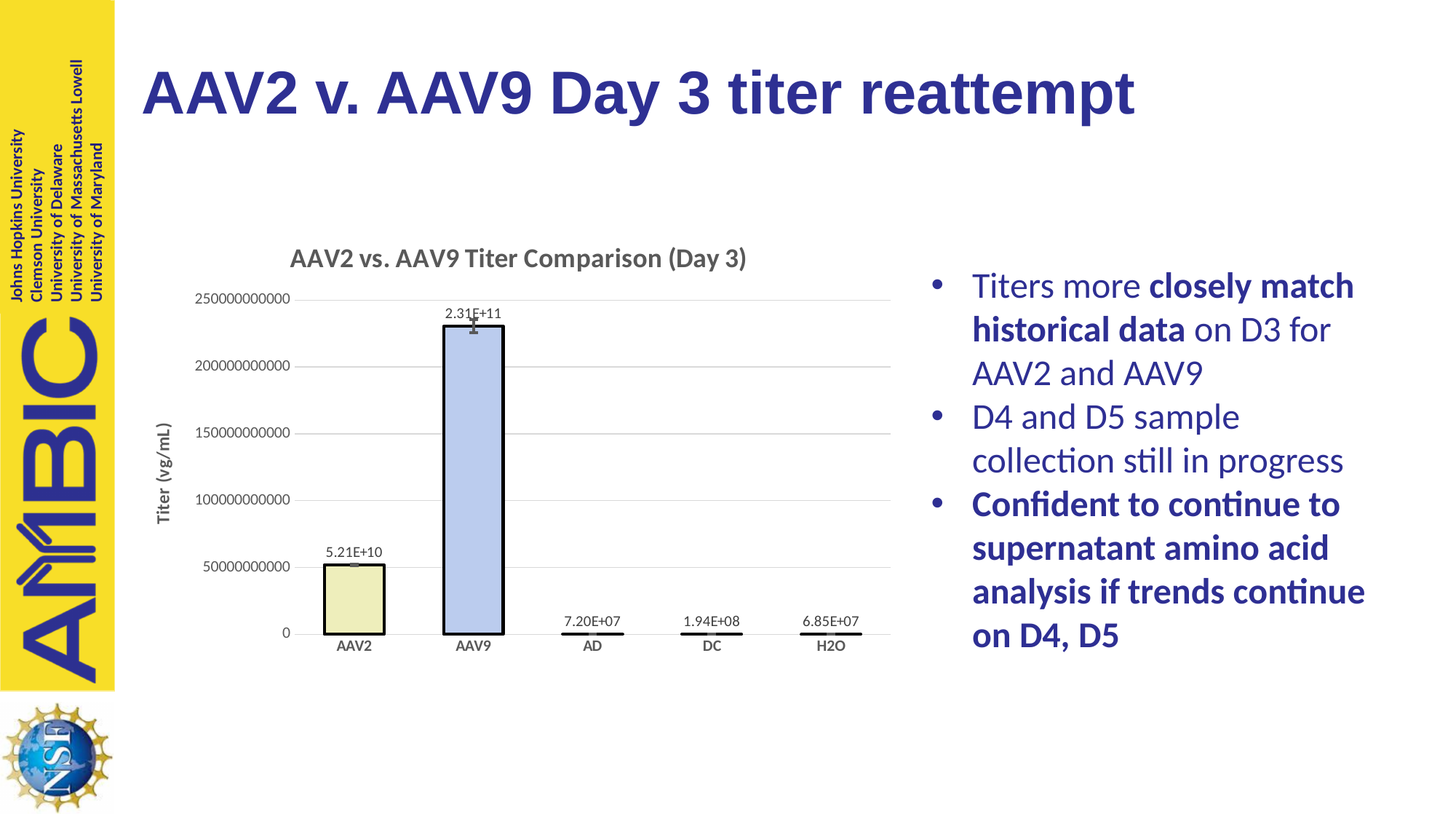
What type of chart is shown on the slide? bar chart What is the titer value shown for AAV2? 5.21E+10 What is the titer value shown for H2O? 6.85E+07 How many categories are shown on the x axis? 5 What is the titer value shown for DC? 1.94E+08 Which has a larger titer, AAV2 or AAV9? AAV9 Which category has the lowest titer? H2O What is the label of the y axis? Titer (vg/mL) What is the titer value shown for AAV9? 2.31E+11 Is the titer value for AAV9 greater or less than 200000000000? greater Which category has the highest titer? AAV9 What is the title of the chart? AAV2 vs. AAV9 Titer Comparison (Day 3)